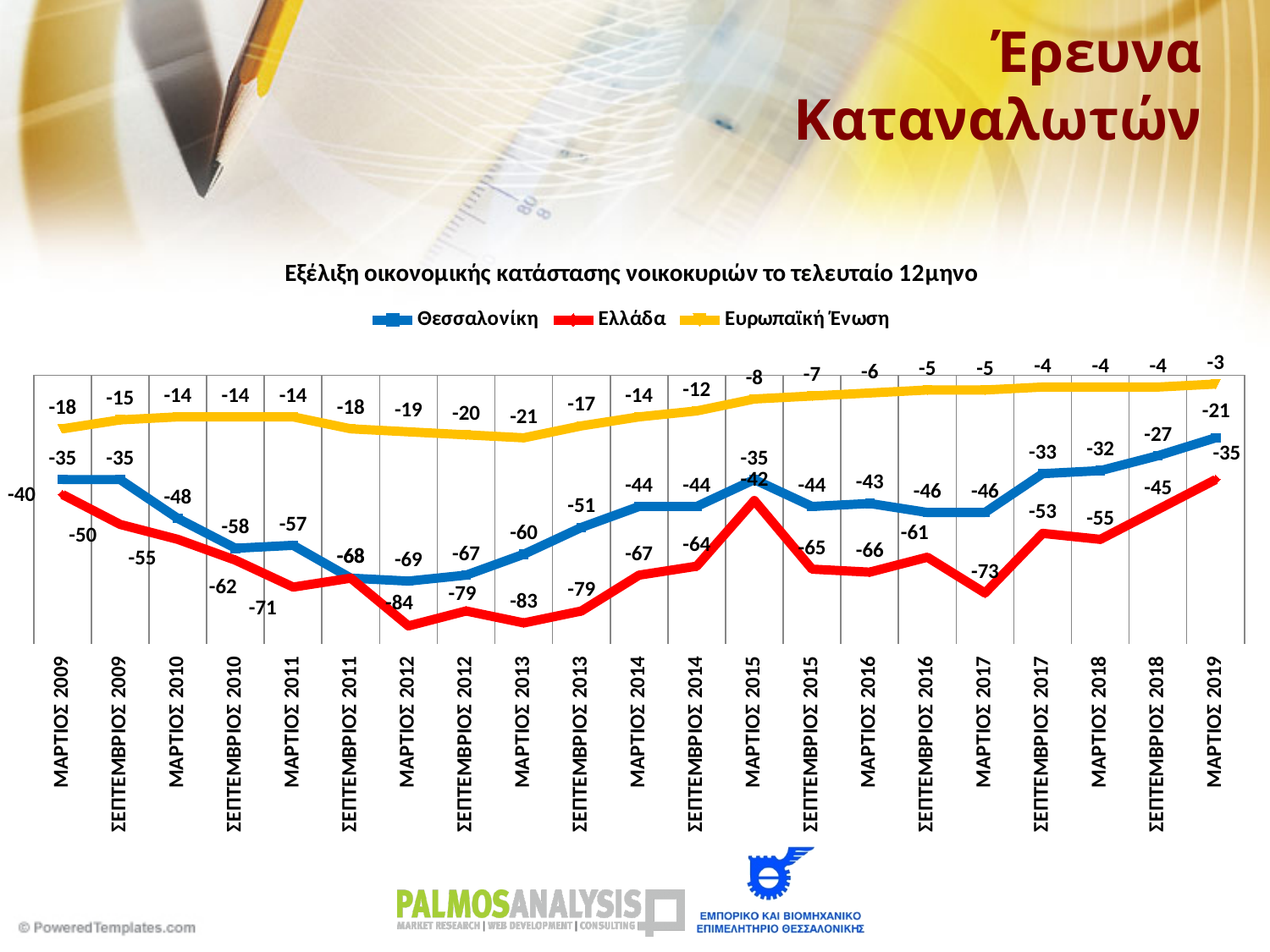
What kind of chart is shown on the slide? line chart What is the title of the chart? Εξέλιξη οικονομικής κατάστασης νοικοκυριών το τελευταίο 12μηνο What is the value for Ευρωπαϊκή Ένωση in ΜΑΡΤΙΟΣ 2019? -3 Which series has the higher value in ΜΑΡΤΙΟΣ 2015, Θεσσαλονίκη or Ελλάδα? Θεσσαλονίκη How many time points are plotted along the x axis? 21 At which time point does Ελλάδα reach its lowest value? ΜΑΡΤΙΟΣ 2012 What is the difference between the Θεσσαλονίκη and Ελλάδα values in ΜΑΡΤΙΟΣ 2019? 14 Does the Ευρωπαϊκή Ένωση series rise or fall from ΜΑΡΤΙΟΣ 2013 to ΜΑΡΤΙΟΣ 2019? rise At which time point does Ευρωπαϊκή Ένωση reach its highest value? ΜΑΡΤΙΟΣ 2019 What is the value for Θεσσαλονίκη in ΣΕΠΤΕΜΒΡΙΟΣ 2010? -58 How many series does the legend list? 3 What is the value for Ελλάδα in ΜΑΡΤΙΟΣ 2012? -84